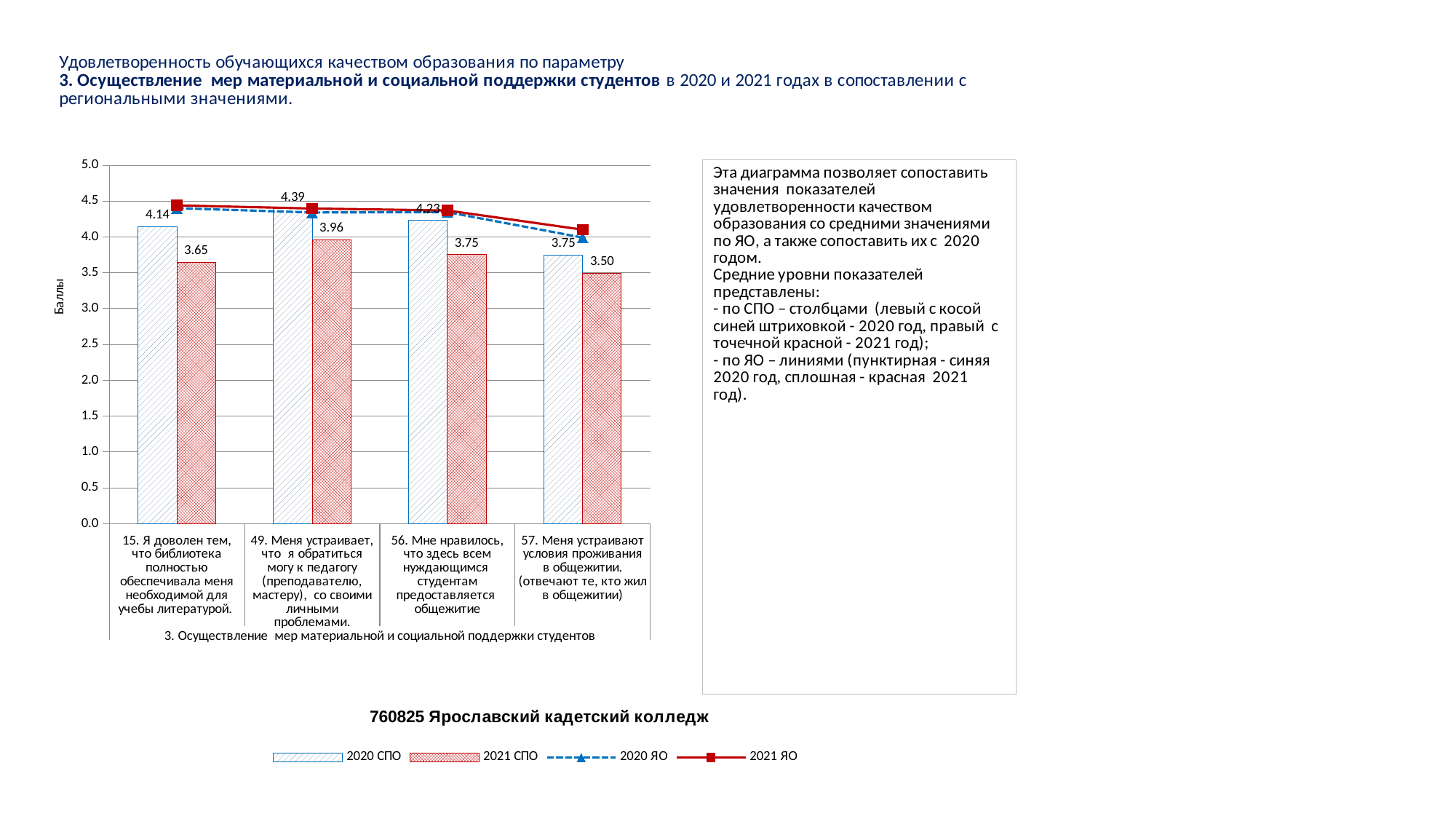
Which is larger for item 57: the 2020 СПО value or the 2021 СПО value? 2020 СПО Which item has the highest 2020 СПО value? 49. Меня устраивает, что я обратиться могу к педагогу How many series does the legend list? 4 How many items (categories) are shown on the x axis? 4 What is the 2021 СПО value for item 49 (Меня устраивает, что я обратиться могу к педагогу)? 3.96 Do the 2021 СПО values rise or fall from item 56 to item 57? fall What is the difference between the 2020 СПО and 2021 СПО values for item 56? 0.48 Is the 2021 ЯО value for item 15 greater or less than 4.0? greater What is the 2020 СПО value for item 15 (Я доволен тем, что библиотека полностью обеспечивала меня необходимой для учебы литературой)? 4.14 Which item has the lowest 2021 СПО value? 57. Меня устраивают условия проживания в общежитии What is the 2021 СПО value for item 57 (Меня устраивают условия проживания в общежитии)? 3.50 What is the difference between the 2020 СПО and 2021 СПО values for item 15? 0.49